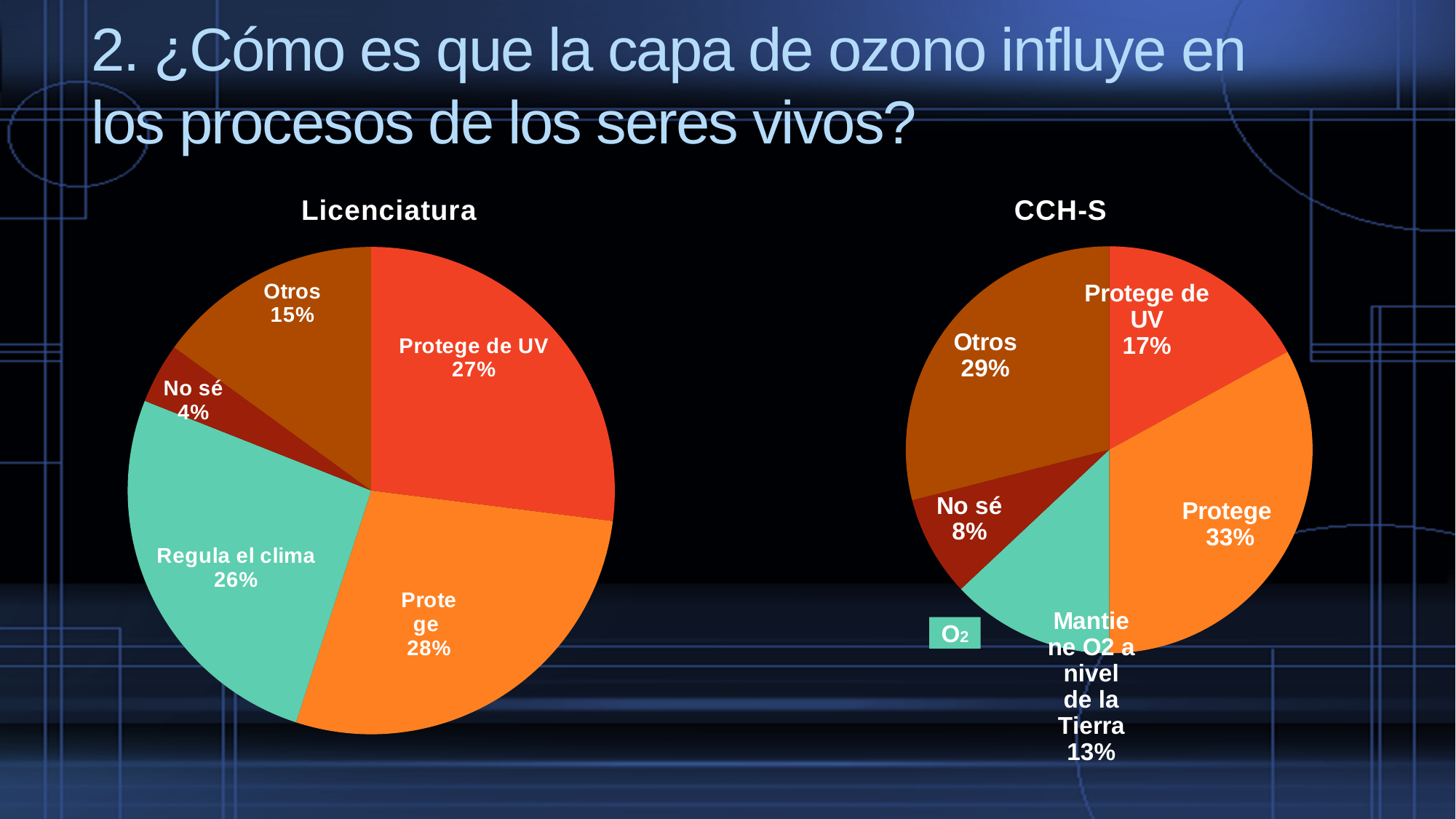
In the Licenciatura chart, what percentage of responses is 'Regula el clima'? 26% In the Licenciatura chart, what percentage of responses is 'No sé'? 4% What type of chart is used for the Licenciatura data? Pie chart In the CCH-S chart, what percentage of responses is 'Otros'? 29% In the CCH-S chart, which category has the largest share? Protege In the CCH-S chart, what percentage of responses is 'Protege de UV'? 17% In the CCH-S chart, which category has the smallest share? No sé How many slices does the CCH-S pie chart have? 5 What is the title of the chart on the right side of the slide? CCH-S Which is larger in the Licenciatura chart: 'Otros' or 'Regula el clima'? Regula el clima In the Licenciatura chart, which category has the smallest share? No sé What is the difference between the 'Otros' shares in the CCH-S chart and the Licenciatura chart? 14 percentage points